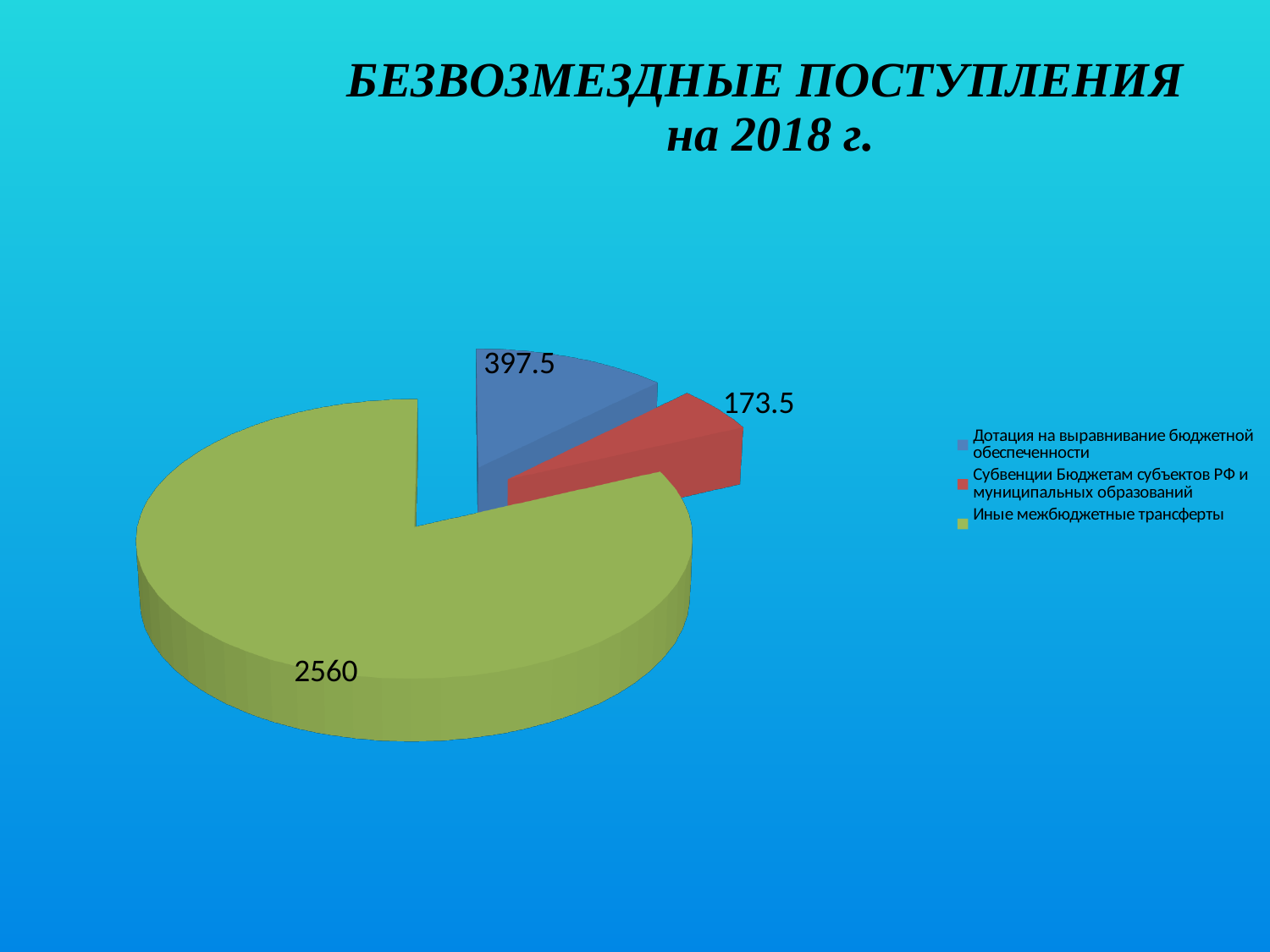
What colour is the slice for Иные межбюджетные трансферты? Green What kind of chart is shown on the slide? Pie chart Which is larger: the value for Дотация на выравнивание бюджетной обеспеченности or the value for Субвенции Бюджетам субъектов РФ и муниципальных образований? Дотация на выравнивание бюджетной обеспеченности Which category has the largest slice of the pie? Иные межбюджетные трансферты How many slices does the pie chart have? 3 What is the value for Дотация на выравнивание бюджетной обеспеченности? 397.5 What is the value for Субвенции Бюджетам субъектов РФ и муниципальных образований? 173.5 Which category has the smallest slice of the pie? Субвенции Бюджетам субъектов РФ и муниципальных образований What is the total of all three slices in the pie chart? 3131 What is the value for Иные межбюджетные трансферты? 2560 What is the difference between the values for Иные межбюджетные трансферты and Дотация на выравнивание бюджетной обеспеченности? 2162.5 What is the difference between the values for Дотация на выравнивание бюджетной обеспеченности and Субвенции Бюджетам субъектов РФ и муниципальных образований? 224